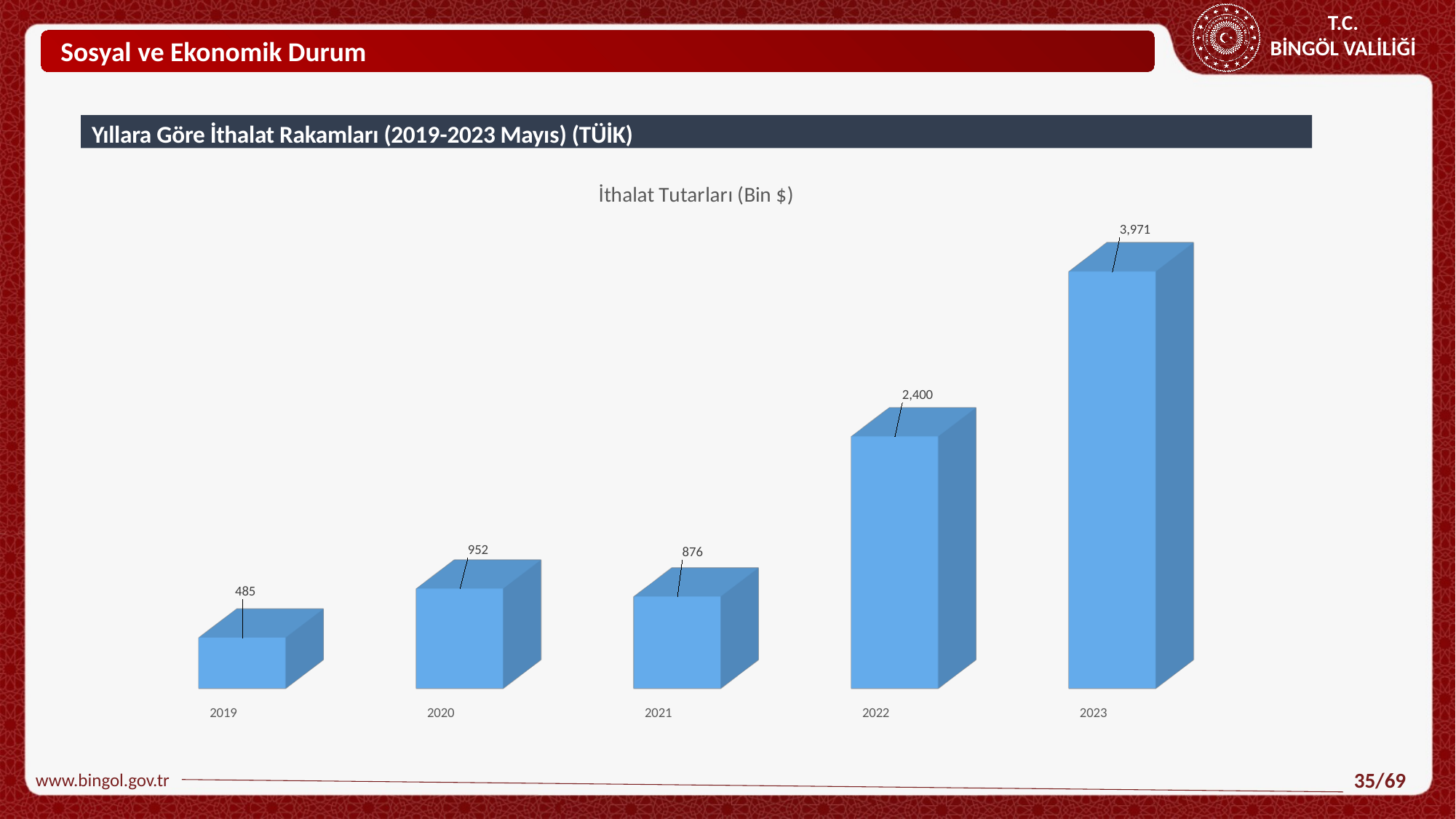
What is the import value for 2019? 485 How many years are shown on the chart? 5 What is the title of the chart? İthalat Tutarları (Bin $) Do the import values generally rise or fall from 2019 to 2023? Rise What is the import value for 2022? 2,400 Which year has a larger import value, 2020 or 2021? 2020 What is the difference between the import values for 2020 and 2021? 76 Which year has the highest import value? 2023 Which year has the lowest import value? 2019 What kind of chart is shown on the slide? Bar chart What is the import value for 2023? 3,971 What is the difference between the import values for 2023 and 2022? 1,571